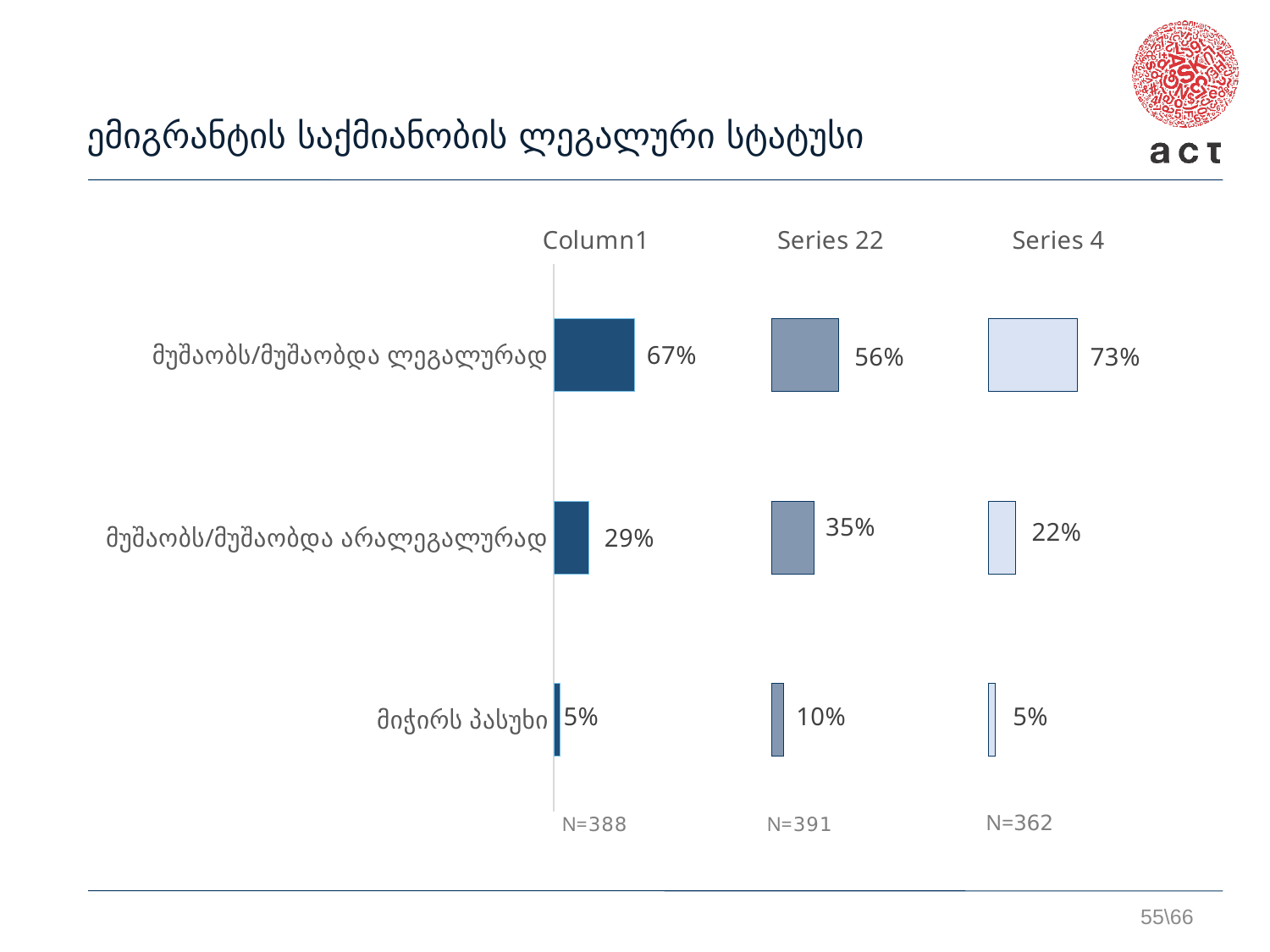
What is the value for "მუშაობს/მუშაობდა არალეგალურად" in the Series 22 series? 35% Which is larger for "მუშაობს/მუშაობდა არალეგალურად": the Column1 value or the Series 4 value? Column1 How many series does the chart show? 3 What kind of chart is shown on the slide? Bar chart What is the value for "მუშაობს/მუშაობდა ლეგალურად" in the Series 4 series? 73% What is the difference between the Column1 and Series 22 values for "მუშაობს/მუშაობდა ლეგალურად"? 11% Which series has the highest value for "მუშაობს/მუშაობდა ლეგალურად"? Series 4 Which category has the lowest value in the Series 22 series? მიჭირს პასუხი How many categories are shown on the chart? 3 What is the sample size (N) shown under the Series 22 series? N=391 What is the value for "მიჭირს პასუხი" in the Series 4 series? 5% What is the value for "მუშაობს/მუშაობდა ლეგალურად" in the Column1 series? 67%